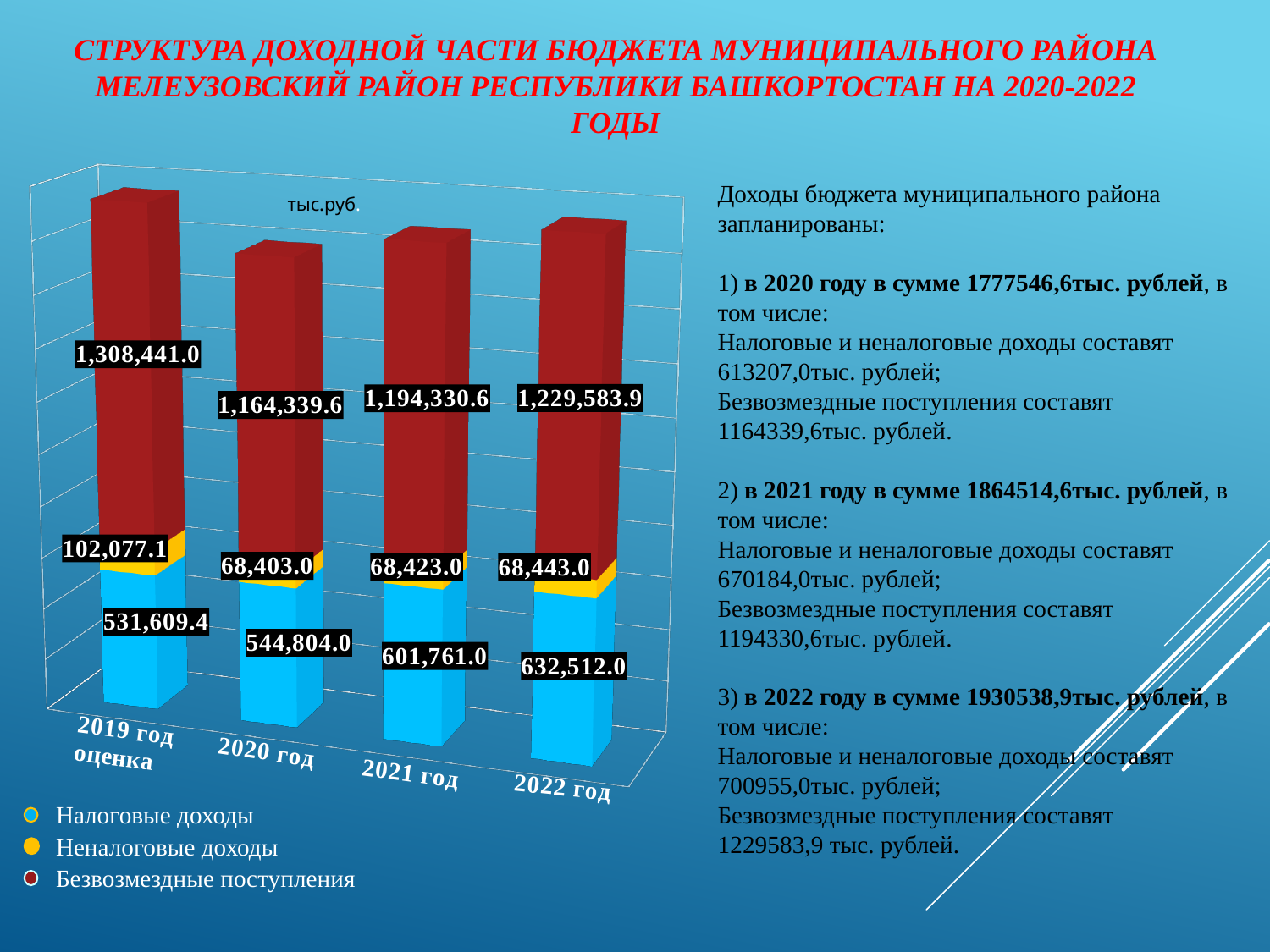
In which year is the value of Налоговые доходы the lowest? 2019 год оценка What is the value of Налоговые доходы for 2021 год? 601,761.0 What is the value of Неналоговые доходы for 2022 год? 68,443.0 Do the values of Налоговые доходы rise or fall from 2019 год оценка to 2022 год? rise What is the total of the stacked bar for 2020 год? 1,777,546.6 What is the value of Безвозмездные поступления for 2019 год оценка? 1,308,441.0 Which is larger: Налоговые доходы in 2022 год or in 2020 год? 2022 год How many series does the chart legend list? 3 How many year categories are plotted on the x axis of the chart? 4 In which year is the value of Безвозмездные поступления the highest? 2019 год оценка What is the difference between Безвозмездные поступления in 2019 год оценка and in 2020 год? 144,101.4 What type of chart is shown on the slide? stacked bar chart